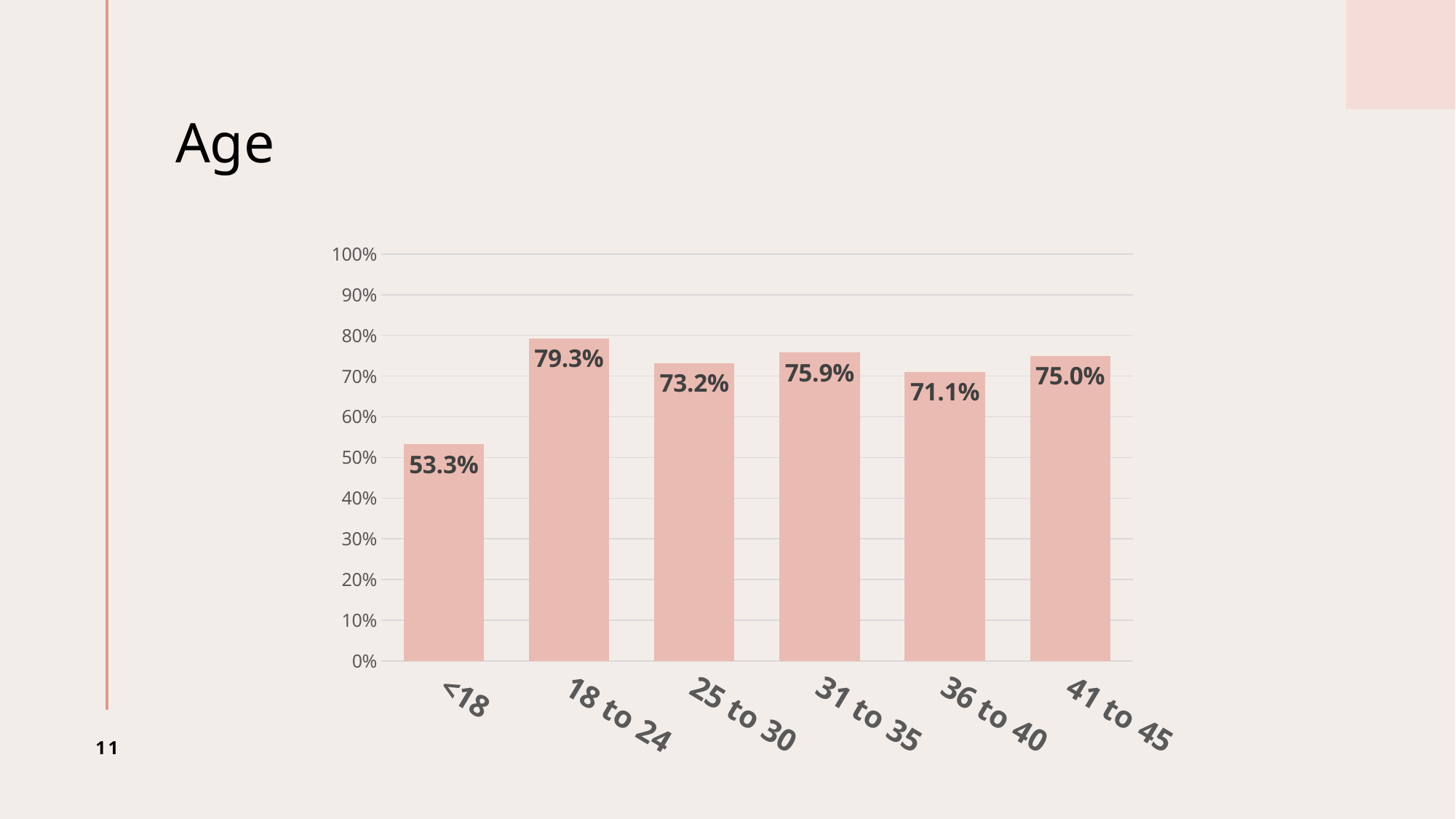
What is the difference between the values for 18 to 24 and <18? 26.0% Which age group has the highest value? 18 to 24 What is the value for the 18 to 24 age group? 79.3% What kind of chart is shown on the slide? Bar chart What is the value for the 41 to 45 age group? 75.0% How many age groups are shown on the chart? 6 Which is larger, the value for 31 to 35 or the value for 36 to 40? 31 to 35 What is the value for the 36 to 40 age group? 71.1% What is the value for the <18 age group? 53.3% Is the value for 25 to 30 greater or less than 70%? greater What is the difference between the values for 31 to 35 and 25 to 30? 2.7% Which age group has the lowest value? <18